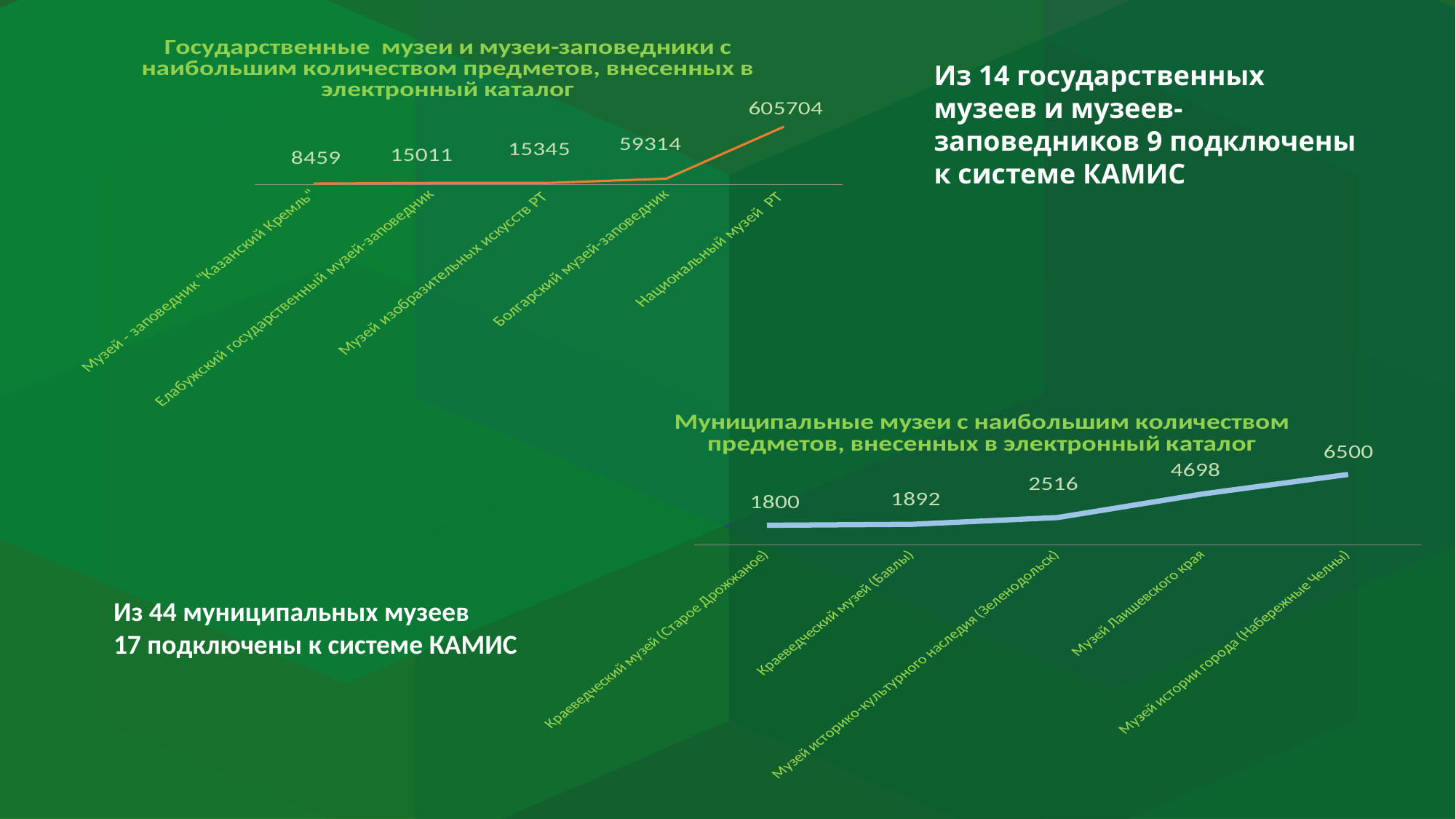
In the bottom chart (Муниципальные музеи), what is the value for Музей Лаишевского края? 4698 In the top chart (Государственные музеи и музеи-заповедники), what is the value for Болгарский музей-заповедник? 59314 In the bottom chart (Муниципальные музеи), which museum has the highest value? Музей истории города (Набережные Челны) In the top chart (Государственные музеи и музеи-заповедники), how many museums are plotted? 5 In the bottom chart (Муниципальные музеи), which is larger: Музей историко-культурного наследия (Зеленодольск) or Краеведческий музей (Бавлы)? Музей историко-культурного наследия (Зеленодольск) In the top chart (Государственные музеи и музеи-заповедники), which museum has the lowest value? Музей-заповедник "Казанский Кремль" What colour is the line in the bottom chart (Муниципальные музеи)? Light blue In the top chart (Государственные музеи и музеи-заповедники), what is the value for Национальный музей РТ? 605704 In the bottom chart (Муниципальные музеи), do the values rise or fall from left to right? Rise What type of chart is the top chart (Государственные музеи и музеи-заповедники)? Line chart In the top chart (Государственные музеи и музеи-заповедники), what is the difference between Музей изобразительных искусств РТ and Елабужский государственный музей-заповедник? 334 In the bottom chart (Муниципальные музеи), what is the difference between Музей истории города (Набережные Челны) and Краеведческий музей (Старое Дрожжаное)? 4700